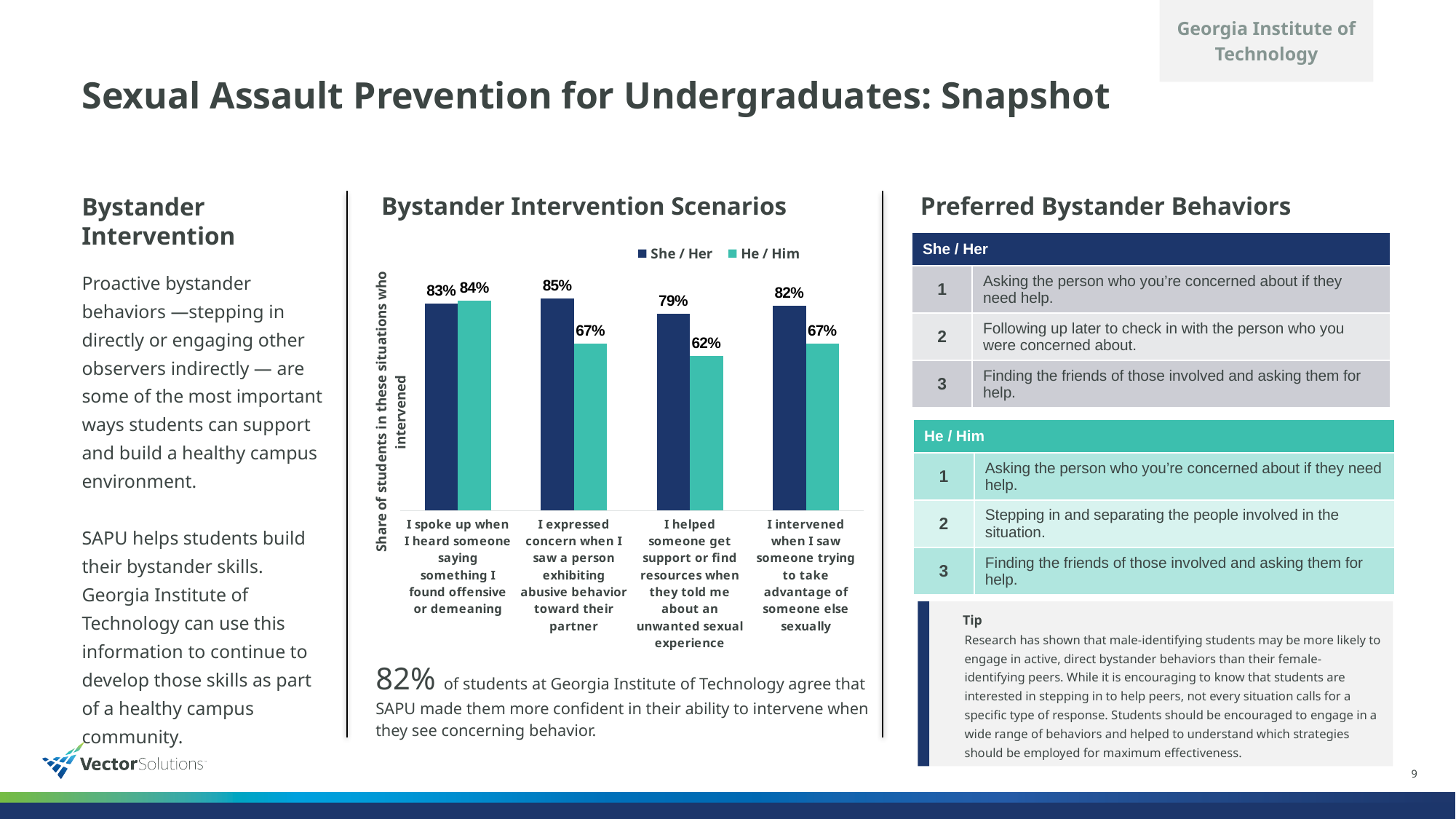
What is the difference between the She / Her and He / Him values for 'I expressed concern when I saw a person exhibiting abusive behavior toward their partner'? 18% What is the She / Her value for 'I intervened when I saw someone trying to take advantage of someone else sexually'? 82% How many scenarios are shown on the x axis of the chart? 4 What is the She / Her value for 'I spoke up when I heard someone saying something I found offensive or demeaning'? 83% What is the He / Him value for 'I helped someone get support or find resources when they told me about an unwanted sexual experience'? 62% What is the He / Him value for 'I expressed concern when I saw a person exhibiting abusive behavior toward their partner'? 67% What kind of chart is 'Bystander Intervention Scenarios'? Bar chart How many series does the chart legend list? 2 What is the title of the chart? Bystander Intervention Scenarios Which scenario has the lowest He / Him value? I helped someone get support or find resources when they told me about an unwanted sexual experience Which scenario has the highest She / Her value? I expressed concern when I saw a person exhibiting abusive behavior toward their partner For 'I spoke up when I heard someone saying something I found offensive or demeaning', which series has the larger value, She / Her or He / Him? He / Him